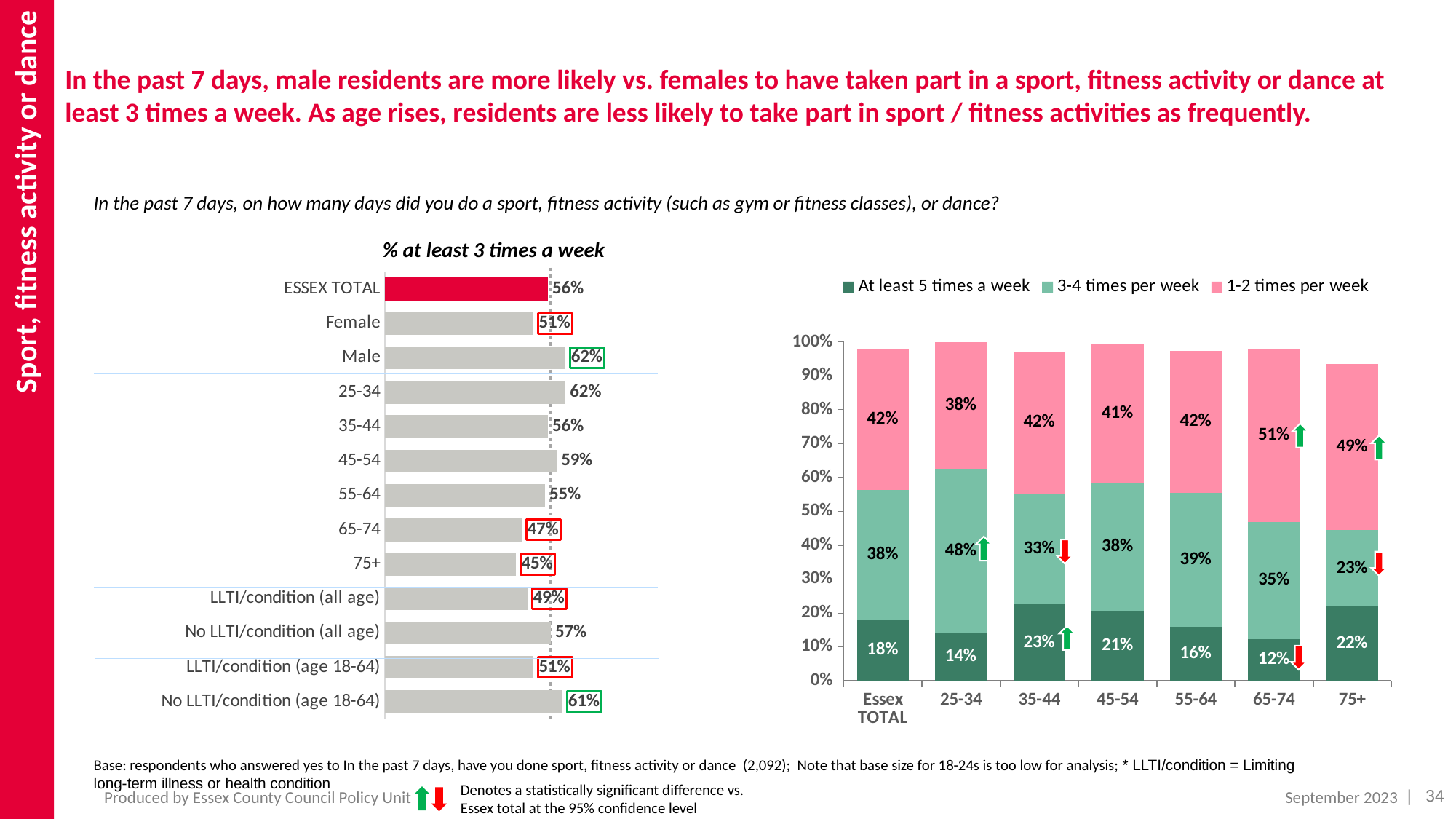
In the '% at least 3 times a week' chart, what is the value for Male? 62% In the '% at least 3 times a week' chart, what is the difference between the Male and Female values? 11% In the '% at least 3 times a week' chart, what is the value for ESSEX TOTAL? 56% In the stacked bar chart on the right, what is the 'At least 5 times a week' value for 35-44? 23% In the stacked bar chart on the right, which age group has the lowest 'At least 5 times a week' value? 65-74 In the stacked bar chart on the right, what is the total of the three labelled segments for 75+? 94% In the '% at least 3 times a week' chart, which category has the lowest value? 75+ In the stacked bar chart on the right, how many series does the legend list? 3 In the '% at least 3 times a week' chart, which is larger: No LLTI/condition (all age) or LLTI/condition (all age)? No LLTI/condition (all age) In the stacked bar chart on the right, what is the '1-2 times per week' value for 65-74? 51% In the '% at least 3 times a week' chart, how many categories are shown? 13 What kind of chart is the chart on the right? Stacked bar chart